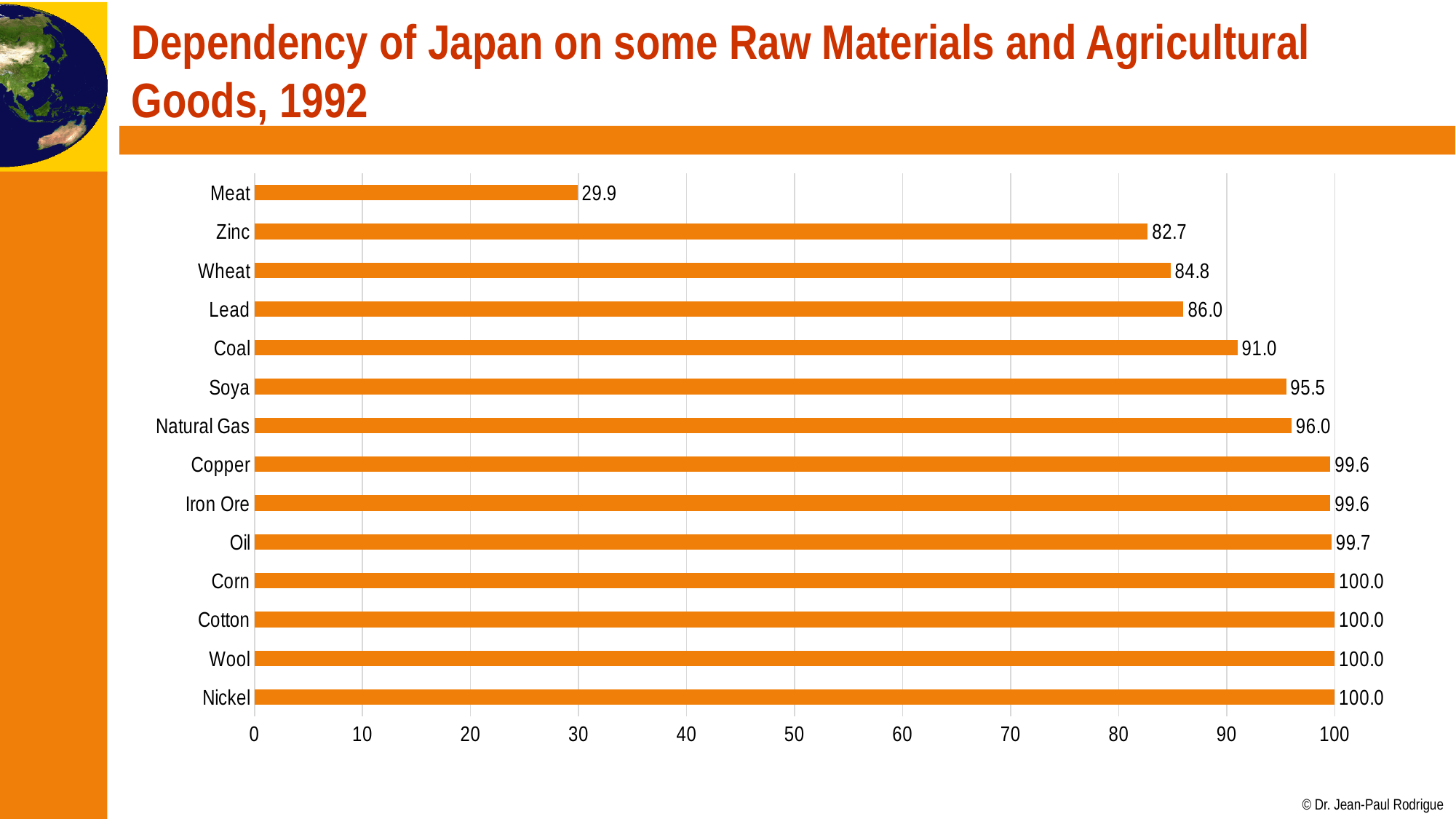
What is the value for Natural Gas? 96.0 Which category has the lowest value? Meat What is the value for Meat? 29.9 How many categories are shown on the chart? 14 Is the value for Wheat greater or less than 80? greater What is the title of the chart on the slide? Dependency of Japan on some Raw Materials and Agricultural Goods, 1992 How many categories have a value of 100.0? 4 What is the difference between the values for Soya and Wheat? 10.7 Which is larger, the value for Lead or the value for Zinc? Lead What kind of chart is shown on the slide? bar chart What is the difference between the values for Zinc and Meat? 52.8 What is the value for Coal? 91.0